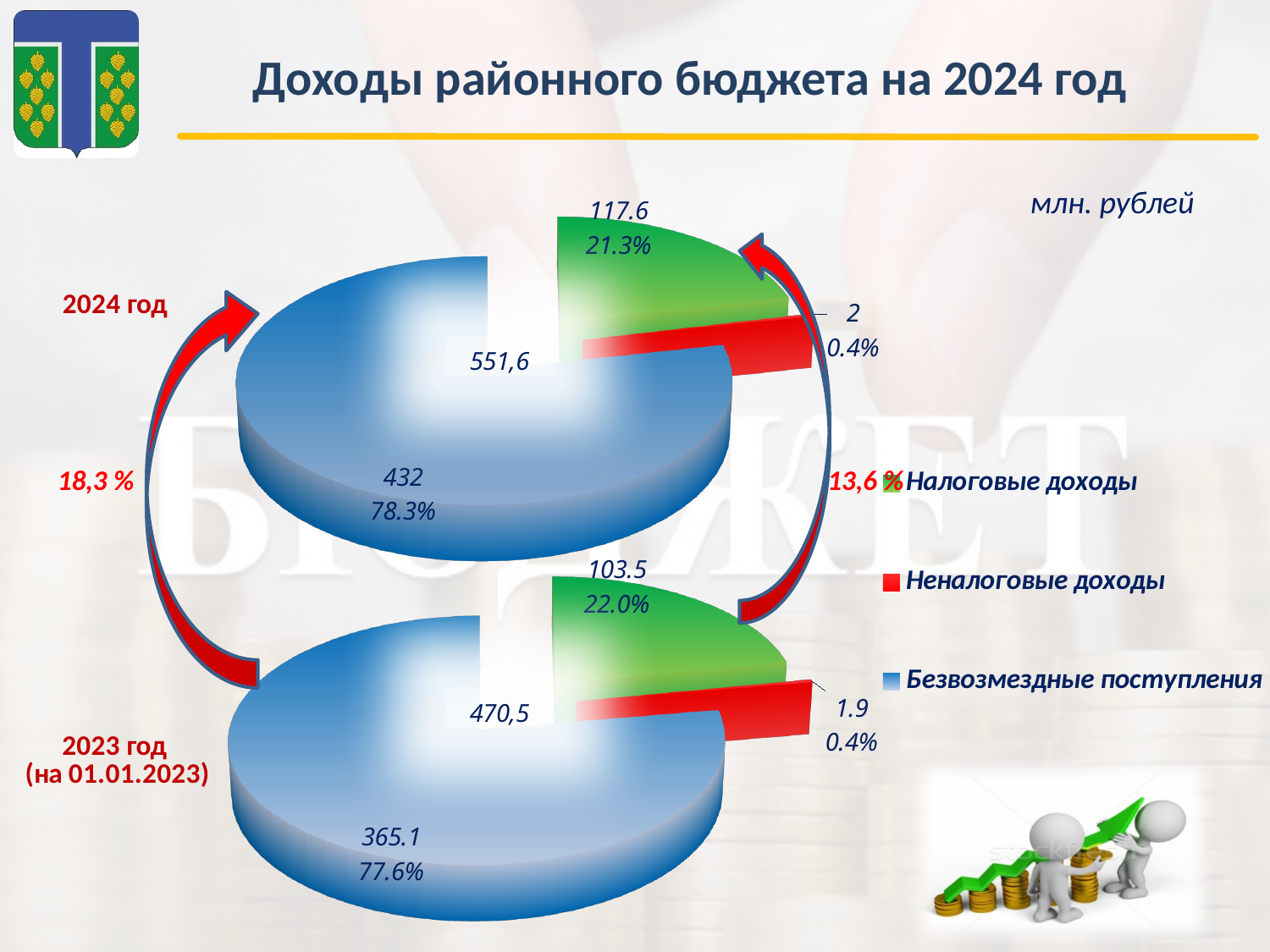
In the 2023 год pie chart, what is the value for Неналоговые доходы? 1.9 Which is larger: Налоговые доходы in the 2024 год chart or in the 2023 год chart? 2024 год What type of chart is used on this slide? Pie chart What is the total shown in the centre of the 2024 год pie chart? 551,6 In the 2024 год pie chart, what share of the pie is Безвозмездные поступления? 78.3% In the 2023 год pie chart, what share of the pie is Налоговые доходы? 22.0% What is the difference between Безвозмездные поступления in the 2024 год chart and in the 2023 год chart? 66.9 In the 2024 год pie chart, what is the value for Налоговые доходы? 117.6 What is the total shown in the centre of the 2023 год pie chart? 470,5 In the 2023 год pie chart, which category is the smallest? Неналоговые доходы In the 2024 год pie chart, which category is the largest? Безвозмездные поступления How many categories does the legend list? 3